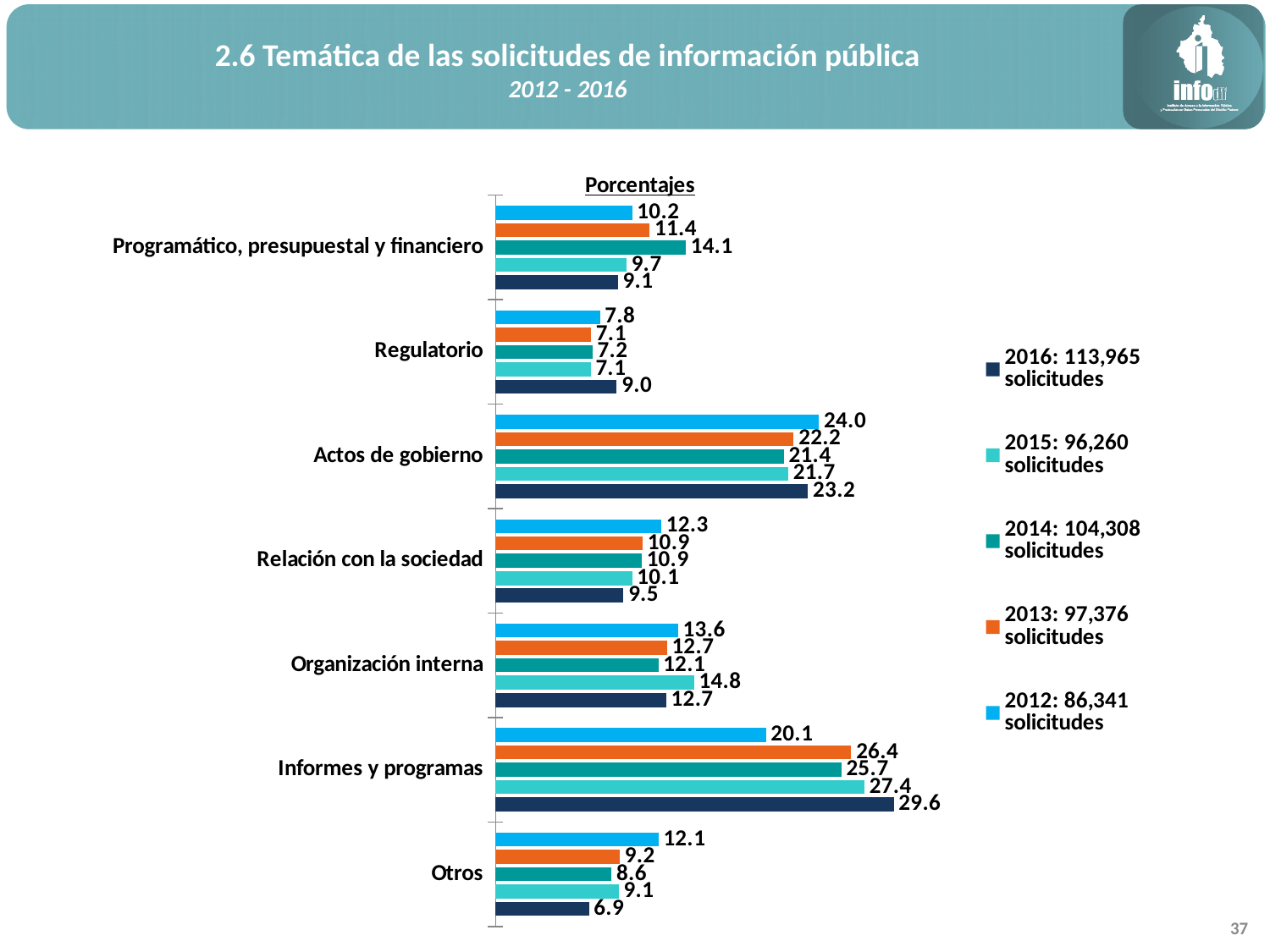
What is the 2016 value for Informes y programas? 29.6 According to the legend, how many solicitudes were there in 2016? 113,965 What kind of chart is shown on the slide? Bar chart What is the 2014 value for Programático, presupuestal y financiero? 14.1 Which category has the highest 2016 value? Informes y programas Which category has the lowest 2016 value? Otros How many series does the legend list? 5 What is the difference between the 2016 and 2012 values for Informes y programas? 9.5 How many categories are shown on the chart? 7 Which is larger for Otros: the 2012 value or the 2016 value? 2012 What is the 2012 value for Actos de gobierno? 24.0 What is the 2015 value for Organización interna? 14.8